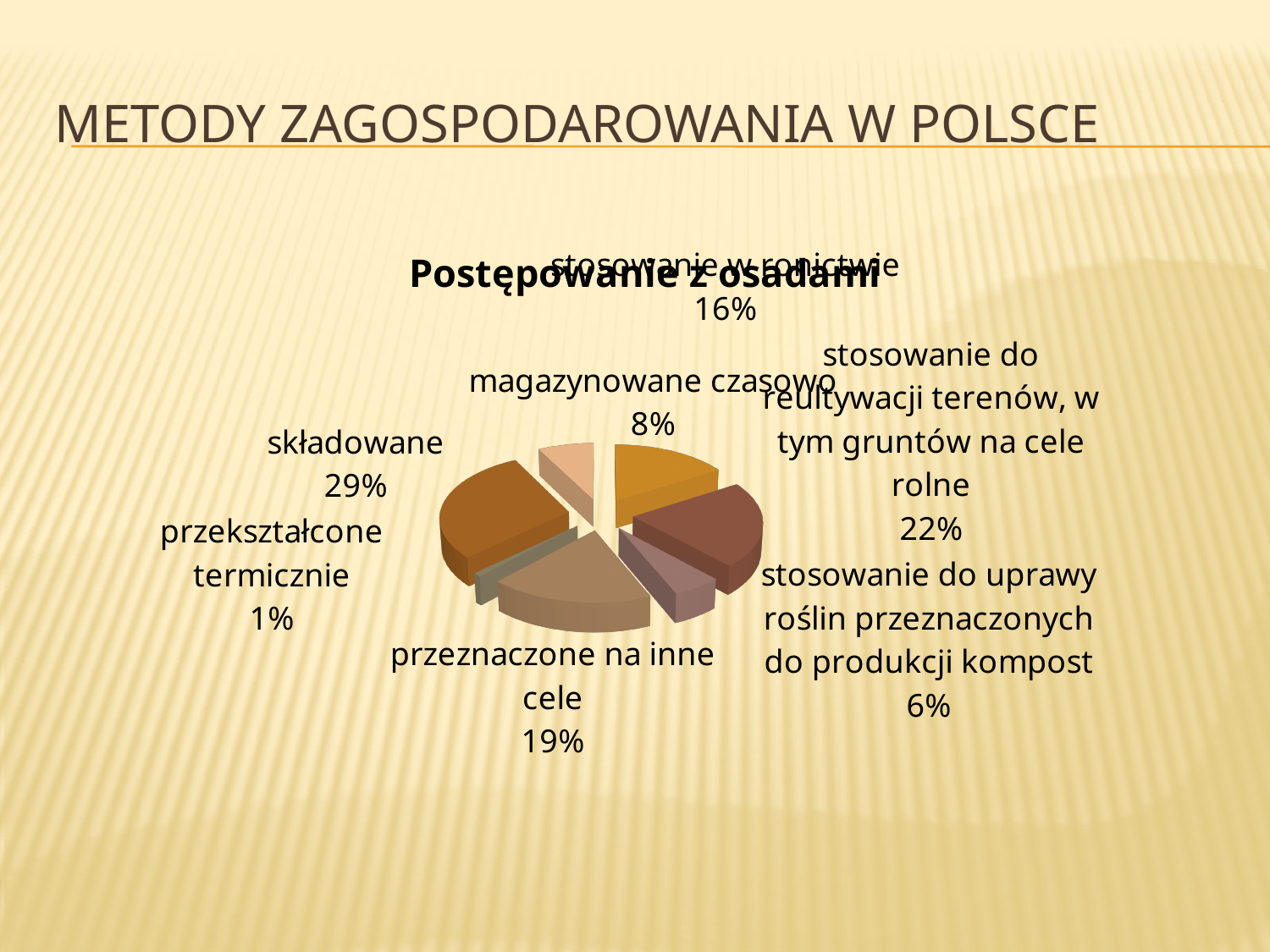
What share of the pie is 'przekształcone termicznie'? 1% Which is larger: the share for 'przeznaczone na inne cele' or the share for 'stosowanie w rolnictwie'? przeznaczone na inne cele What share of the pie is 'przeznaczone na inne cele'? 19% What is the title of the chart? Postępowanie z osadami Which category has the smallest share of the pie? przekształcone termicznie What kind of chart is shown on the slide? pie chart Which category has the largest share of the pie? składowane How many slices does the pie chart have? 7 What share of the pie is 'stosowanie w rolnictwie'? 16% What share of the pie is 'magazynowane czasowo'? 8% What is the difference in percentage points between 'składowane' and 'stosowanie do rekultywacji terenów, w tym gruntów na cele rolne'? 7 What share of the pie is 'składowane'? 29%